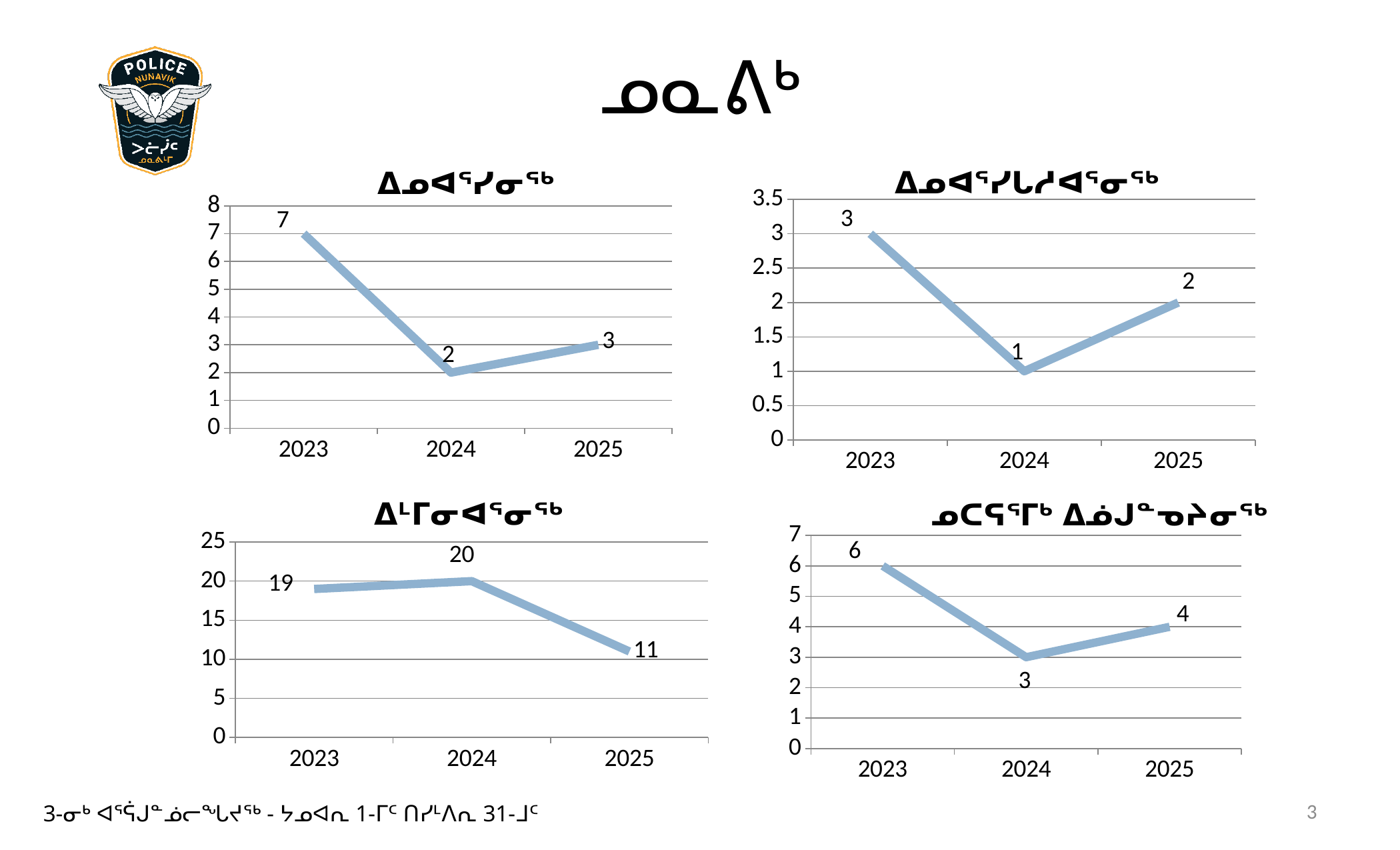
In the bottom-left chart, what is the value for 2024? 20 What kind of chart is the top-left chart? line chart In the top-right chart, what is the value for 2025? 2 In the top-right chart, which year has the highest value? 2023 In the top-left chart, what is the difference between the 2023 and 2024 values? 5 In the top-left chart, what is the value for 2023? 7 In the bottom-right chart, is the value for 2025 larger or smaller than the value for 2024? larger In the bottom-left chart, which year has the lowest value? 2025 In the bottom-left chart, what is the difference between the 2024 and 2025 values? 9 How many data points are plotted in the bottom-right chart? 3 In the top-left chart, which year has the lowest value? 2024 In the bottom-right chart, what is the value for 2023? 6